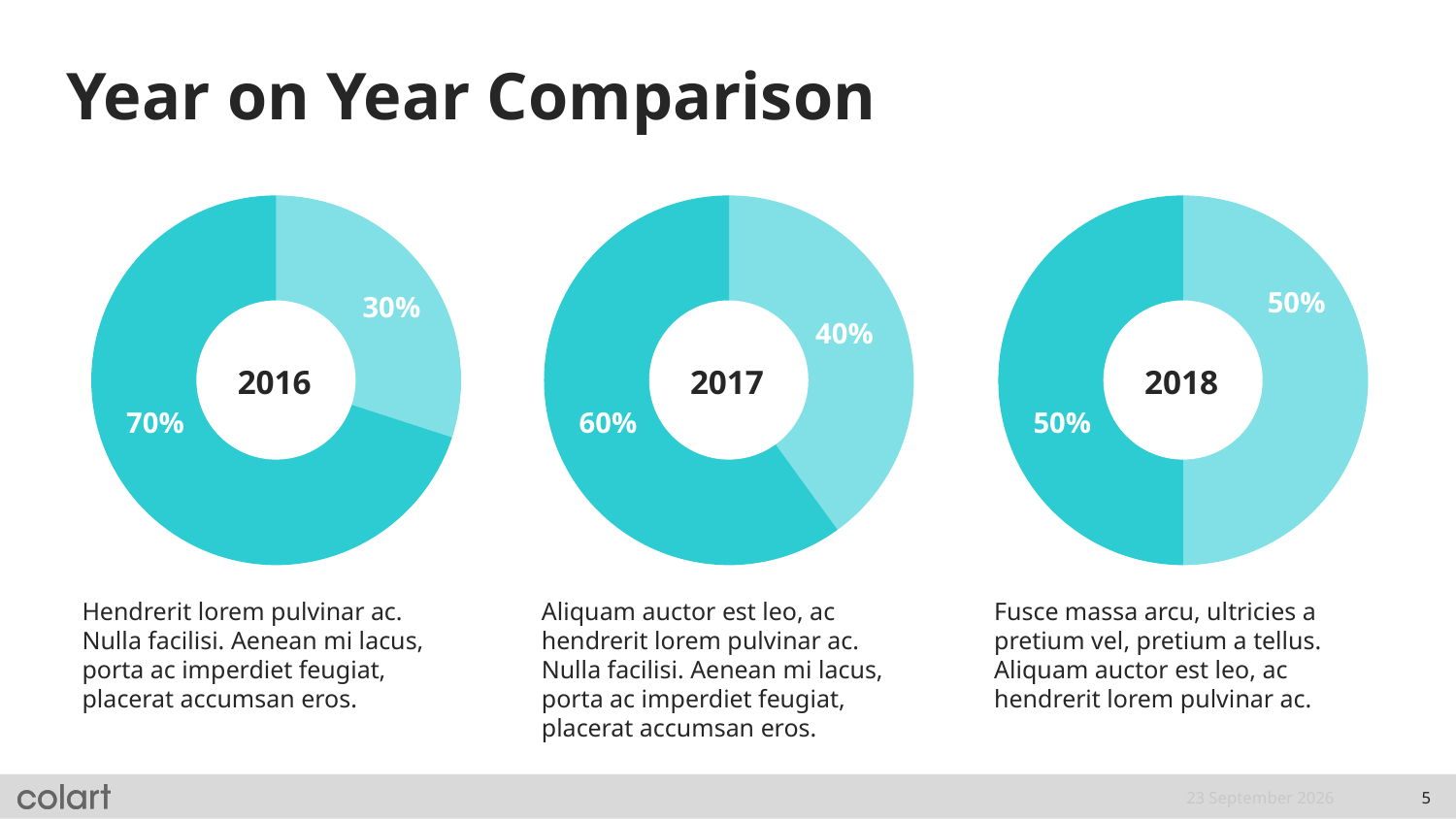
In the 2017 chart, which slice is larger, the darker teal one or the lighter teal one? The darker teal one In the 2018 chart, what value is shown for each of the two slices? 50% In the 2017 chart, what value is shown for the lighter teal slice? 40% In the 2017 chart, what value is shown for the darker teal slice? 60% What kind of chart is used for the 2016 chart? Donut chart In the 2017 chart, what is the difference between the darker teal slice and the lighter teal slice? 20% How many slices does the 2018 chart have? 2 In the 2016 chart, what value is shown for the lighter teal slice? 30% How many donut charts are shown on the slide? 3 What is the title of the slide containing the three donut charts? Year on Year Comparison In the 2016 chart, what is the difference between the two slices? 40% In the 2016 chart, what value is shown for the larger, darker teal slice? 70%